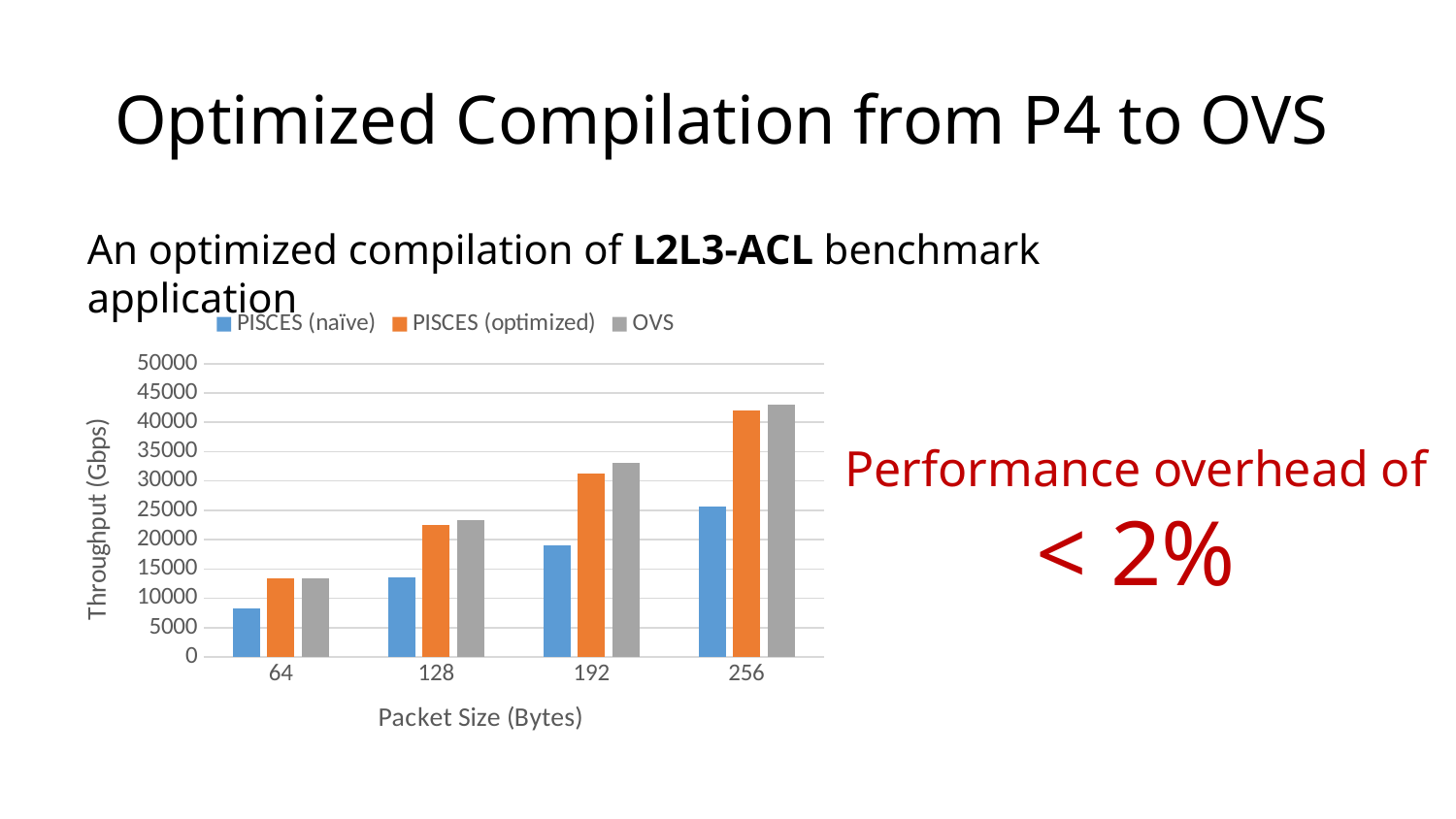
What kind of chart is shown on the slide? bar chart How many packet size categories are shown on the x axis? 4 Which series is listed first in the legend? PISCES (naïve) At which packet size is the OVS throughput lowest? 64 At which packet size is the PISCES (naïve) throughput highest? 256 Is the OVS value at packet size 256 greater or less than 40000? greater Is the PISCES (naïve) value at packet size 64 greater or less than 10000? less Is the PISCES (naïve) value at packet size 192 greater or less than 20000? less At packet size 256, which is larger: PISCES (naïve) or OVS? OVS How many series does the legend list? 3 What is the label of the y axis? Throughput (Gbps)